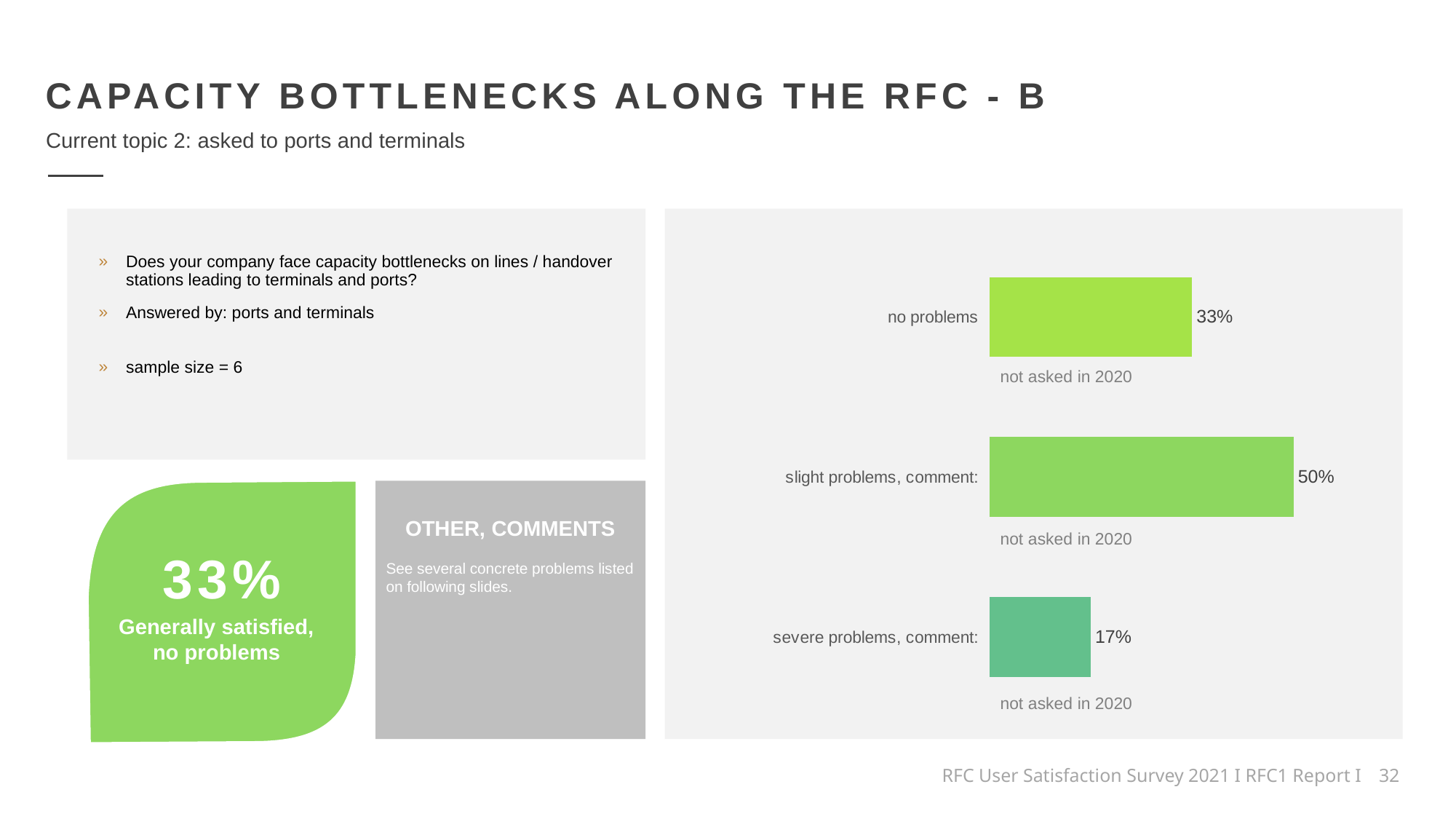
How many categories are shown in the chart? 3 What is the difference in percentage points between slight problems and severe problems? 33 What kind of chart is shown on the slide? bar chart Which is larger, the value for no problems or the value for severe problems? no problems What percentage of respondents reported slight problems? 50% What percentage of respondents reported severe problems? 17% Which category has the lowest percentage? severe problems, comment: What note appears under each bar regarding the 2020 survey? not asked in 2020 What is the sample size stated for this question? 6 What is the difference in percentage points between slight problems and no problems? 17 What percentage of respondents reported no problems? 33% Which category has the highest percentage? slight problems, comment: